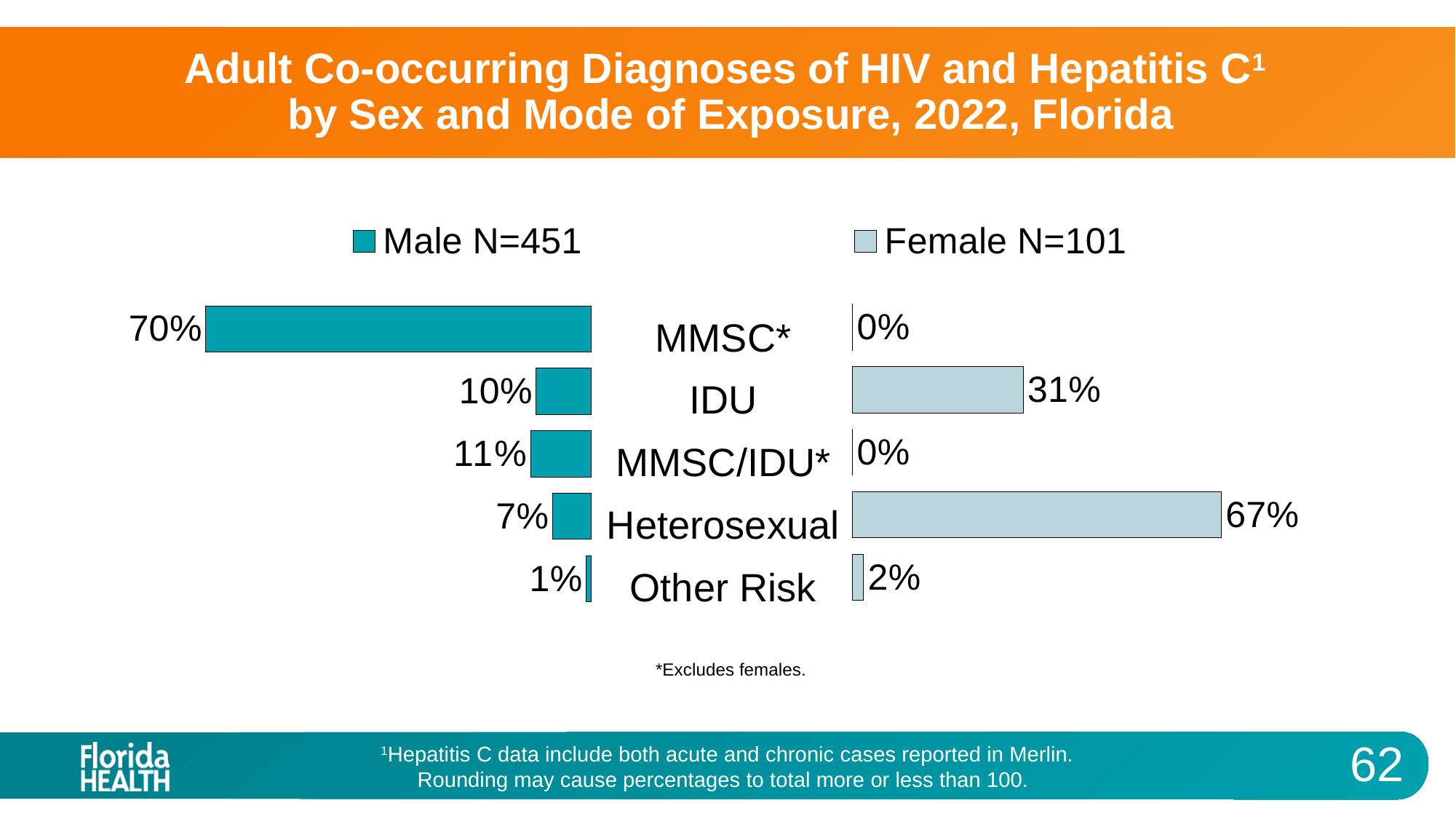
Which mode of exposure has the highest percentage for females? Heterosexual How many series does the legend list? 2 What percentage of males had Other Risk as the mode of exposure? 1% Which mode of exposure has the highest percentage for males? MMSC* What type of chart is shown on the slide? Bar chart Which mode of exposure has the lowest percentage for males? Other Risk What is the difference between the female and male percentages for Heterosexual exposure? 60% What percentage of females had Heterosexual as the mode of exposure? 67% What percentage of females had IDU as the mode of exposure? 31% How many modes of exposure are shown in the chart? 5 What percentage of males had MMSC as the mode of exposure? 70% Which is larger, the male percentage for IDU or the female percentage for IDU? Female